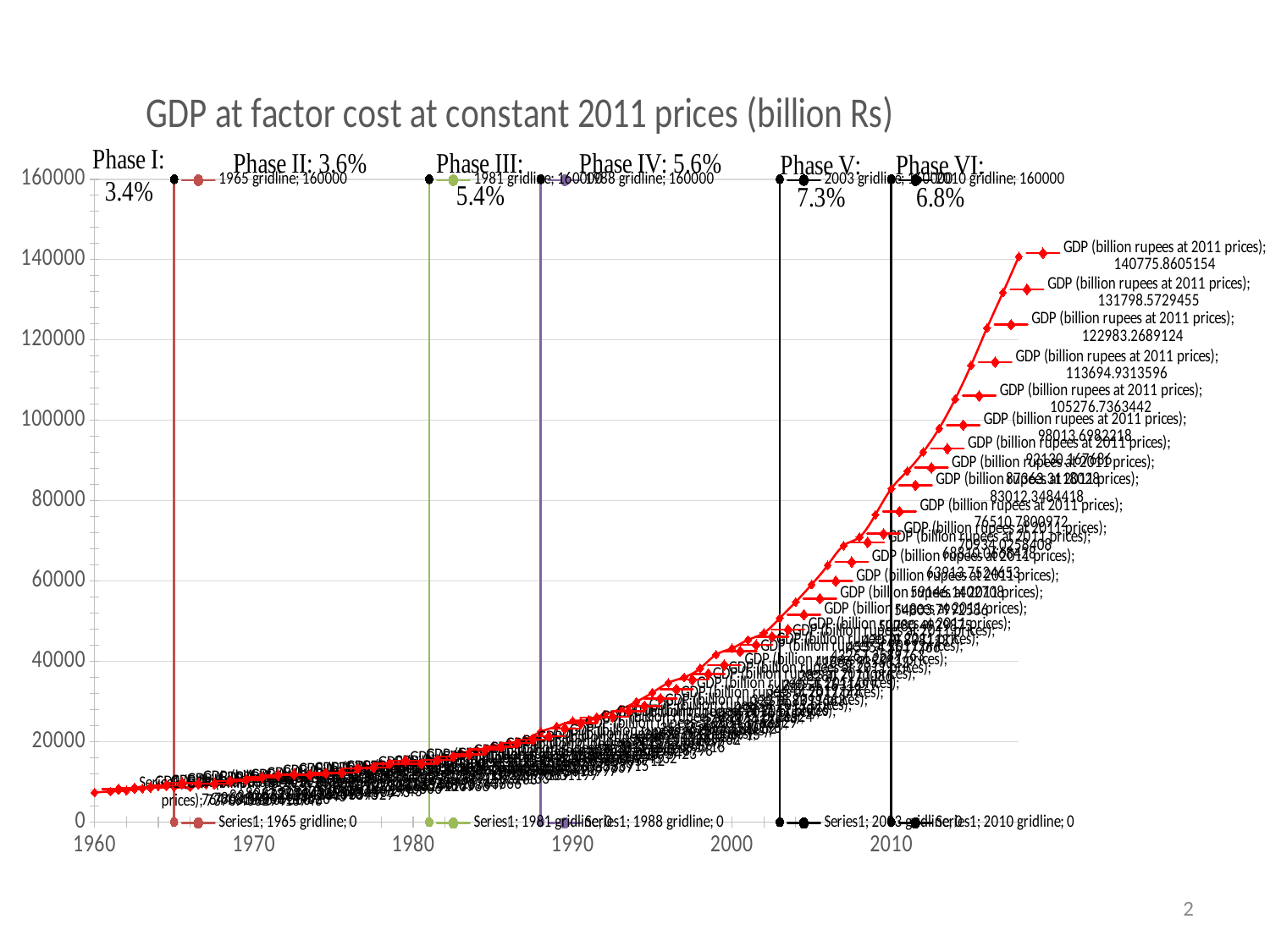
What kind of chart is used to show GDP over time? line chart How many phases are annotated on the chart? 6 Does GDP rise or fall along the x axis from 1960 onward? rise What growth rate is annotated for Phase I? 3.4% Is the GDP value in 2000 greater or less than 40000? greater What is the difference between the two highest labelled GDP values, 140775.8605154 and 131798.5729455? 8977.2875699 What is the title of the chart? GDP at factor cost at constant 2011 prices (billion Rs) Which phase annotation shows the highest growth rate? Phase V: 7.3% What is the highest GDP value labelled on the chart? 140775.8605154 What is the second-highest GDP value labelled on the chart? 131798.5729455 Is the GDP value in 1980 greater or less than 20000? less Is the GDP value in 1990 greater or less than 40000? less